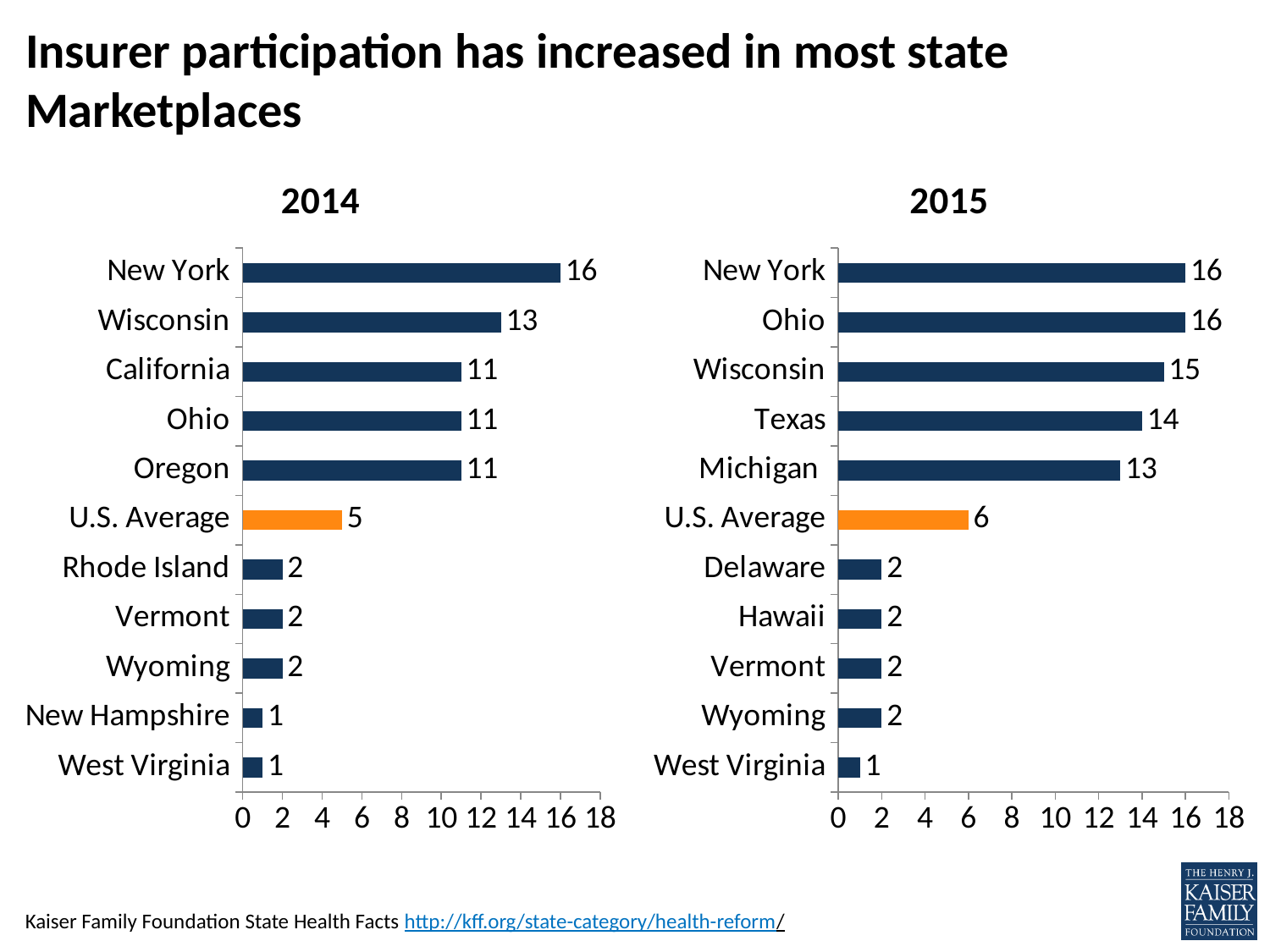
How many categories are shown in the 2015 chart? 11 In the 2015 chart, what is the value for the U.S. Average? 6 What kind of chart is the 2014 chart? bar chart In the 2015 chart, what is the difference between Wisconsin and Michigan? 2 In the 2014 chart, what is the difference between New York and the U.S. Average? 11 In the 2014 chart, what is the value for Wisconsin? 13 In the 2015 chart, what is the value for Texas? 14 In the 2014 chart, what colour is the U.S. Average bar? orange In the 2015 chart, is the value for Michigan greater or less than 10? greater In the 2014 chart, which is larger, the value for Wisconsin or the value for California? Wisconsin In the 2014 chart, which category has the highest value? New York In the 2015 chart, which category has the lowest value? West Virginia